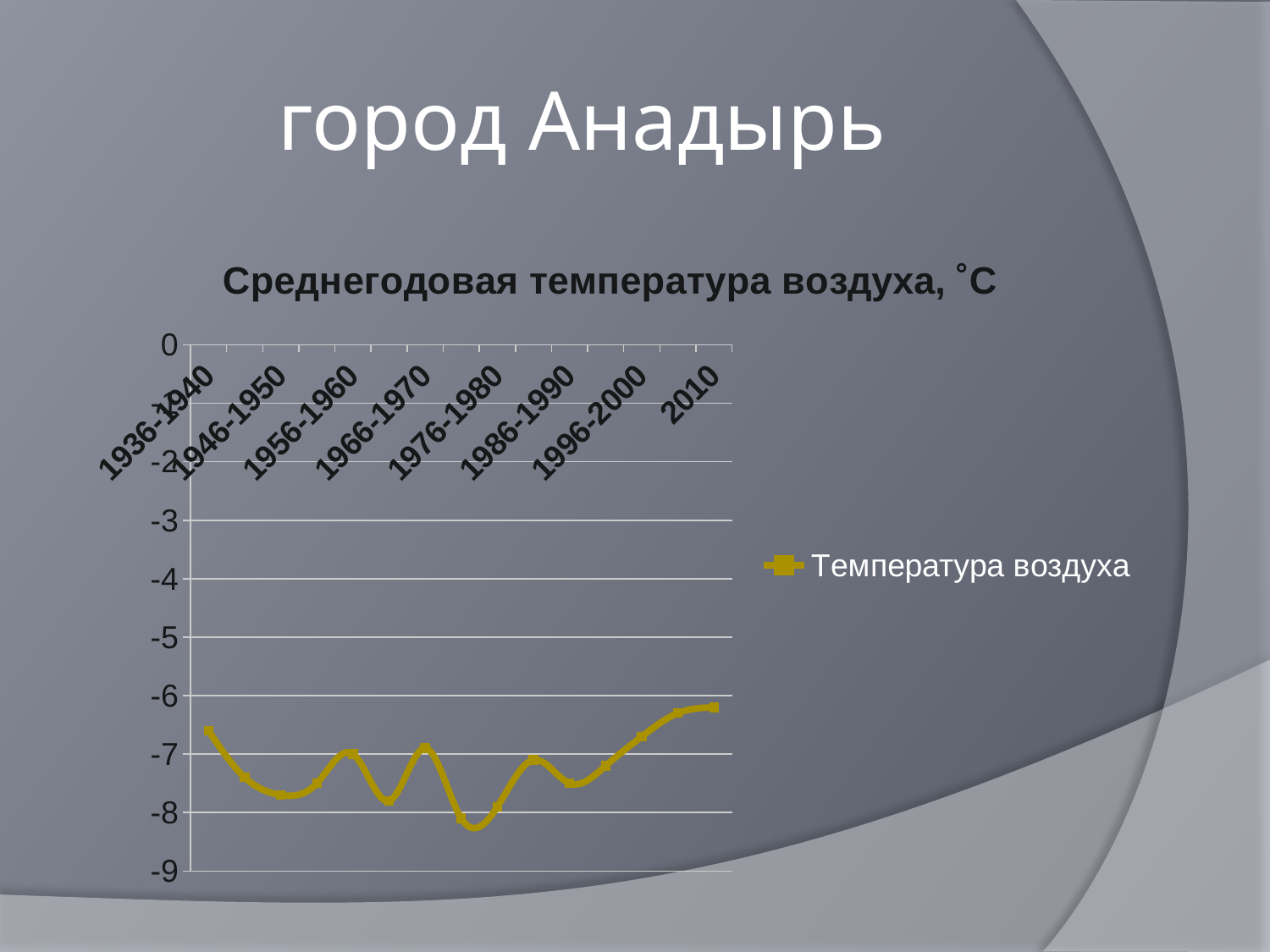
Is the value for 1946-1950 greater or less than -7? less Which labeled period has the highest temperature value? 2010 How many period labels are shown on the x axis? 8 What is the title of the chart? Среднегодовая температура воздуха, ˚С Is the value for 1976-1980 greater or less than -7? less What is the name of the series shown in the legend? Температура воздуха Which is larger, the value for 1936-1940 or the value for 1946-1950? 1936-1940 What kind of chart is shown on the slide? line chart Is the value for 2010 greater or less than -7? greater How many series does the legend list? 1 Between 1986-1990 and 2010, does the temperature value rise or fall? rise